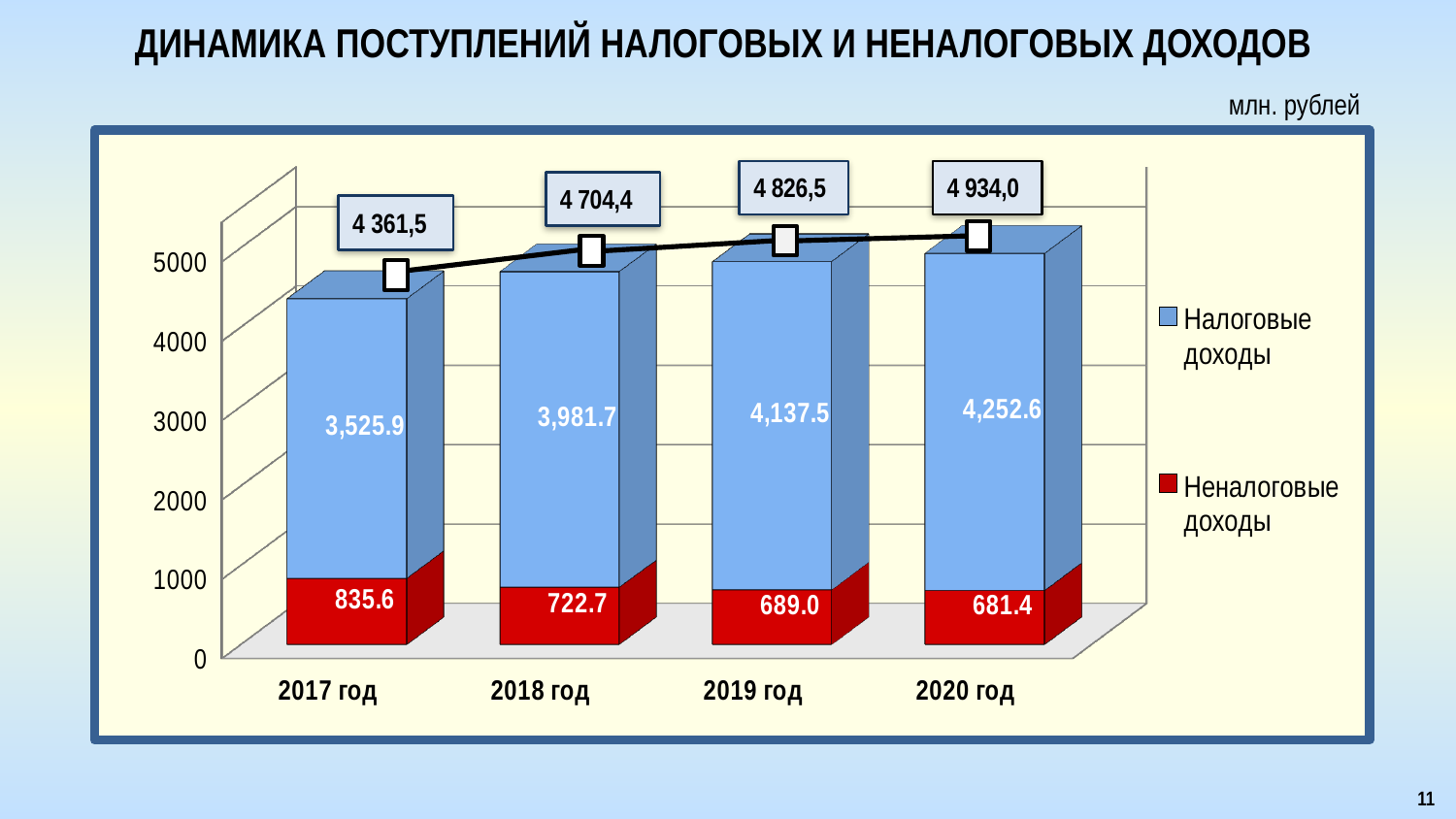
Do the values of Неналоговые доходы rise or fall from 2017 год to 2020 год? Fall What is the value of Неналоговые доходы for 2020 год? 681.4 How many years are shown on the x axis? 4 How many series does the legend list? 2 What is the value of Налоговые доходы for 2017 год? 3,525.9 What total is shown in the callout above the bar for 2018 год? 4 704,4 What is the difference between Налоговые доходы in 2018 год and 2017 год? 455.8 Which year has the highest value of Неналоговые доходы? 2017 год Which is larger: Неналоговые доходы in 2018 год or in 2019 год? 2018 год Which year has the lowest value of Налоговые доходы? 2017 год What kind of chart is shown on the slide? Stacked bar chart What is the value of Налоговые доходы for 2019 год? 4,137.5